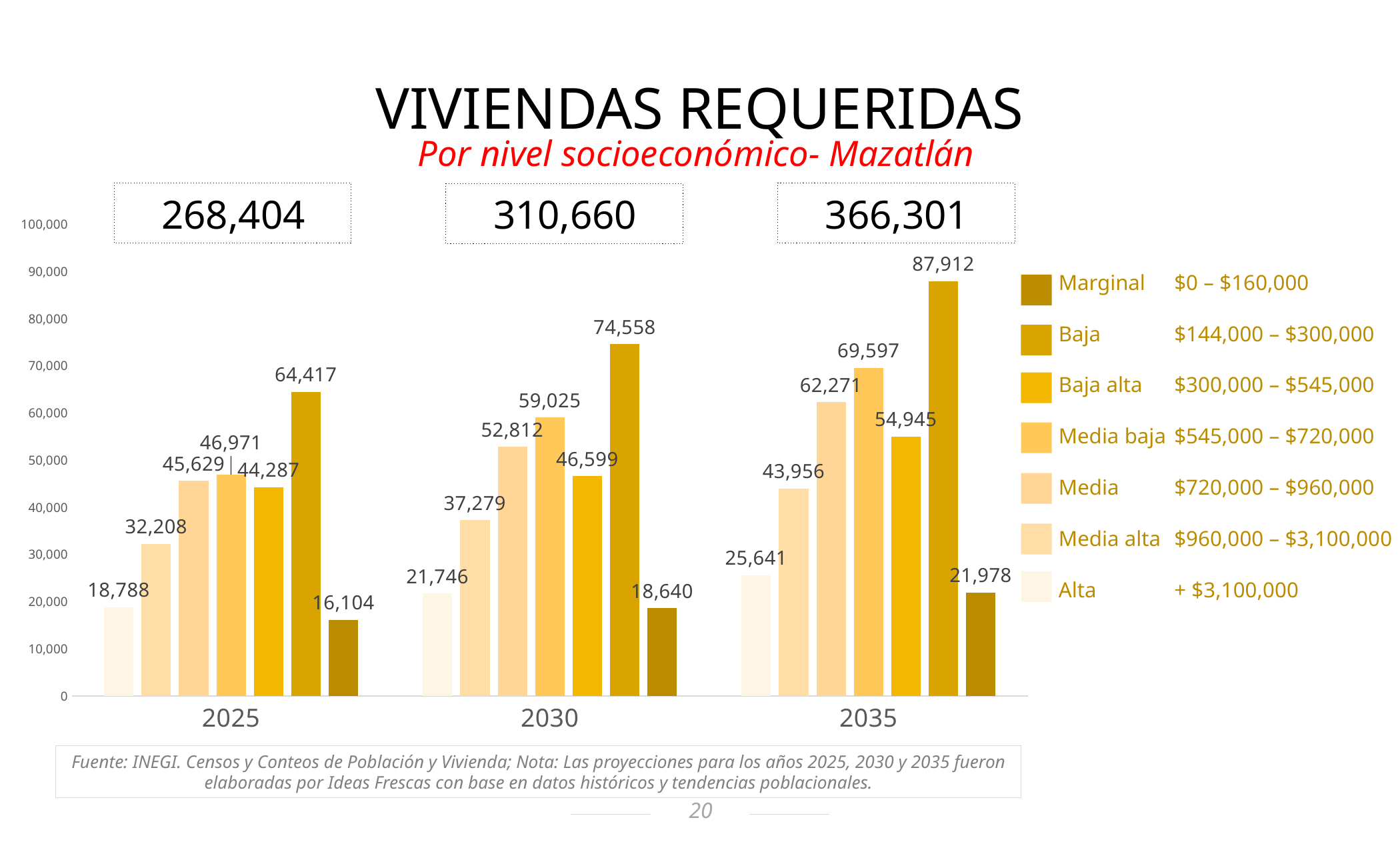
Which socioeconomic level has the highest value in 2030? Baja What kind of chart is shown on the slide? bar chart Is the value for Alta in 2035 greater or less than 30,000? less Do the values for Baja rise or fall from 2025 to 2035? rise Which socioeconomic level has the lowest value in 2025? Marginal In 2025, which is larger: the value for Media baja or the value for Media? Media baja What is the value for Baja in 2035? 87,912 What is the value for Alta in 2030? 21,746 How many series does the legend list? 7 What is the difference between the Baja value in 2035 and the Baja value in 2030? 13,354 What is the total number of viviendas requeridas shown for 2025? 268,404 How many year groups are shown on the x axis? 3